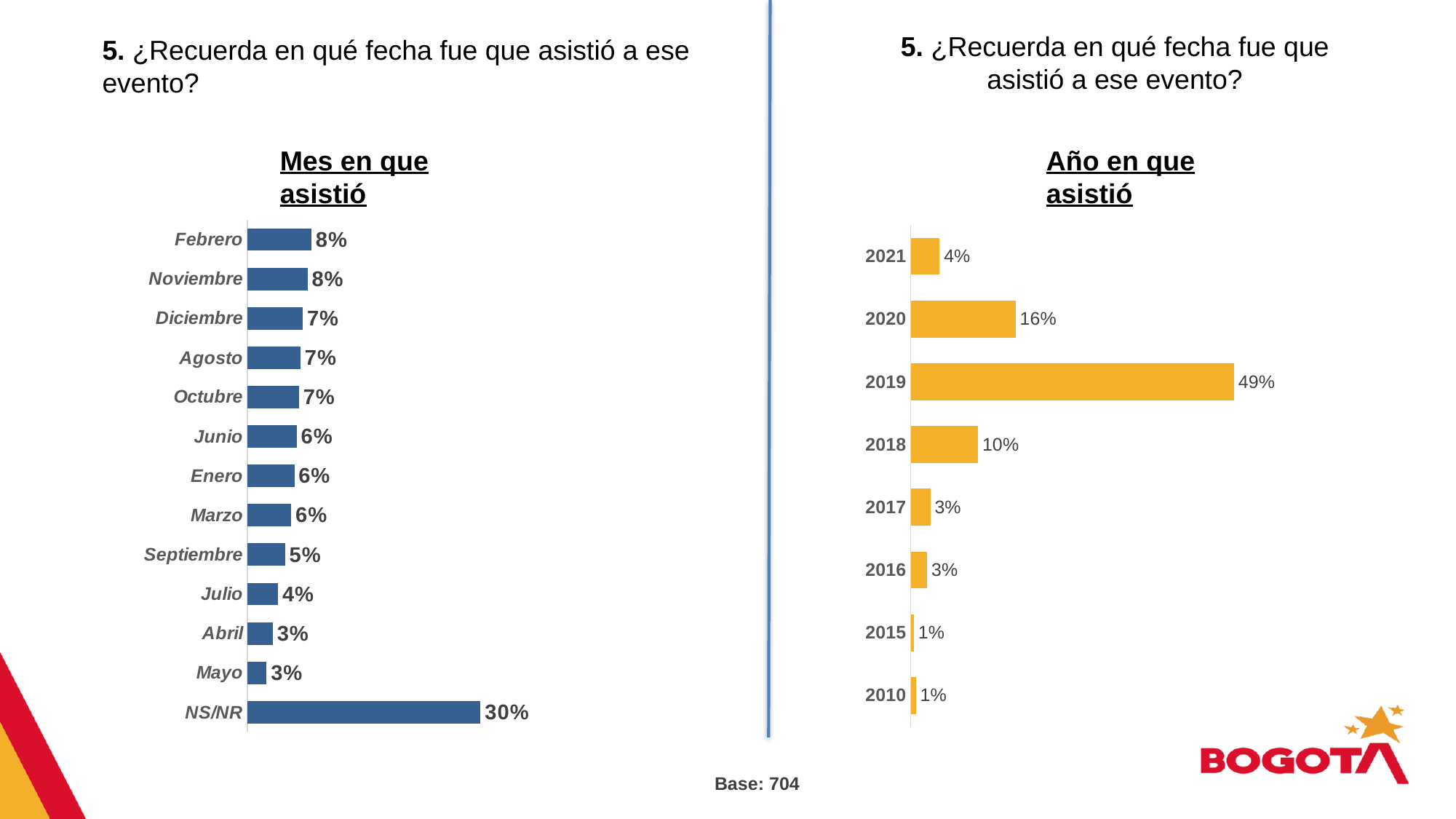
In the 'Año en que asistió' chart, what is the difference between the values for 2019 and 2020? 33% In the 'Año en que asistió' chart, which year has the highest value? 2019 How many categories are shown in the 'Mes en que asistió' chart? 13 How many years are shown in the 'Año en que asistió' chart? 8 In the 'Año en que asistió' chart, which is larger, the value for 2018 or the value for 2021? 2018 In the 'Mes en que asistió' chart, what is the difference between the values for Febrero and Julio? 4% What kind of chart is the 'Año en que asistió' chart? Bar chart In the 'Mes en que asistió' chart, what is the value for NS/NR? 30% In the 'Año en que asistió' chart, what is the value for 2020? 16% In the 'Mes en que asistió' chart, which category has the highest value? NS/NR In the 'Mes en que asistió' chart, what is the value for Septiembre? 5% What colour are the bars in the 'Mes en que asistió' chart? Blue